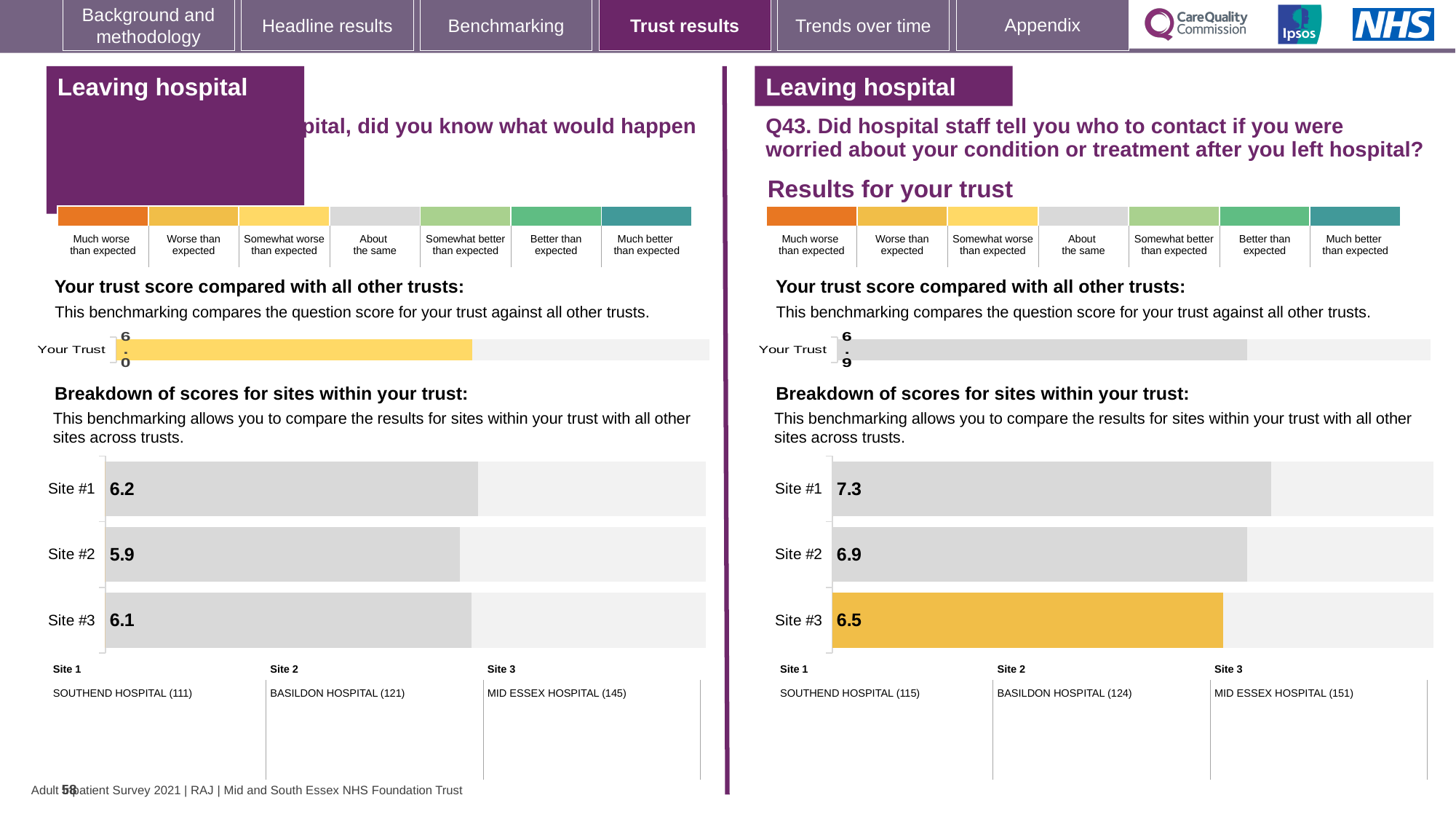
How many sites are shown in the Q43 site breakdown chart on the right half of the slide? 3 In the Q43 site breakdown chart on the right half of the slide, which site has the lowest score? Site #3 What type of chart is used for the site breakdown on the left half of the slide? Bar chart In the site breakdown chart on the left half of the slide, what is the score for Site #2? 5.9 In the Q43 site breakdown chart on the right half of the slide, what is the difference between the scores for Site #1 and Site #3? 0.8 In the site breakdown chart on the left half of the slide, what is the difference between the scores for Site #1 and Site #2? 0.3 In the 'Your Trust' chart on the right half of the slide (Q43), what is the trust score? 6.9 In the site breakdown chart on the left half of the slide, which has the higher score, Site #2 or Site #3? Site #3 In the Q43 site breakdown chart on the right half of the slide, which site's bar is coloured yellow rather than grey? Site #3 In the Q43 site breakdown chart on the right half of the slide, what is the score for Site #3? 6.5 In the site breakdown chart on the left half of the slide, which site has the highest score? Site #1 In the Q43 site breakdown chart on the right half of the slide, what is the score for Site #1? 7.3